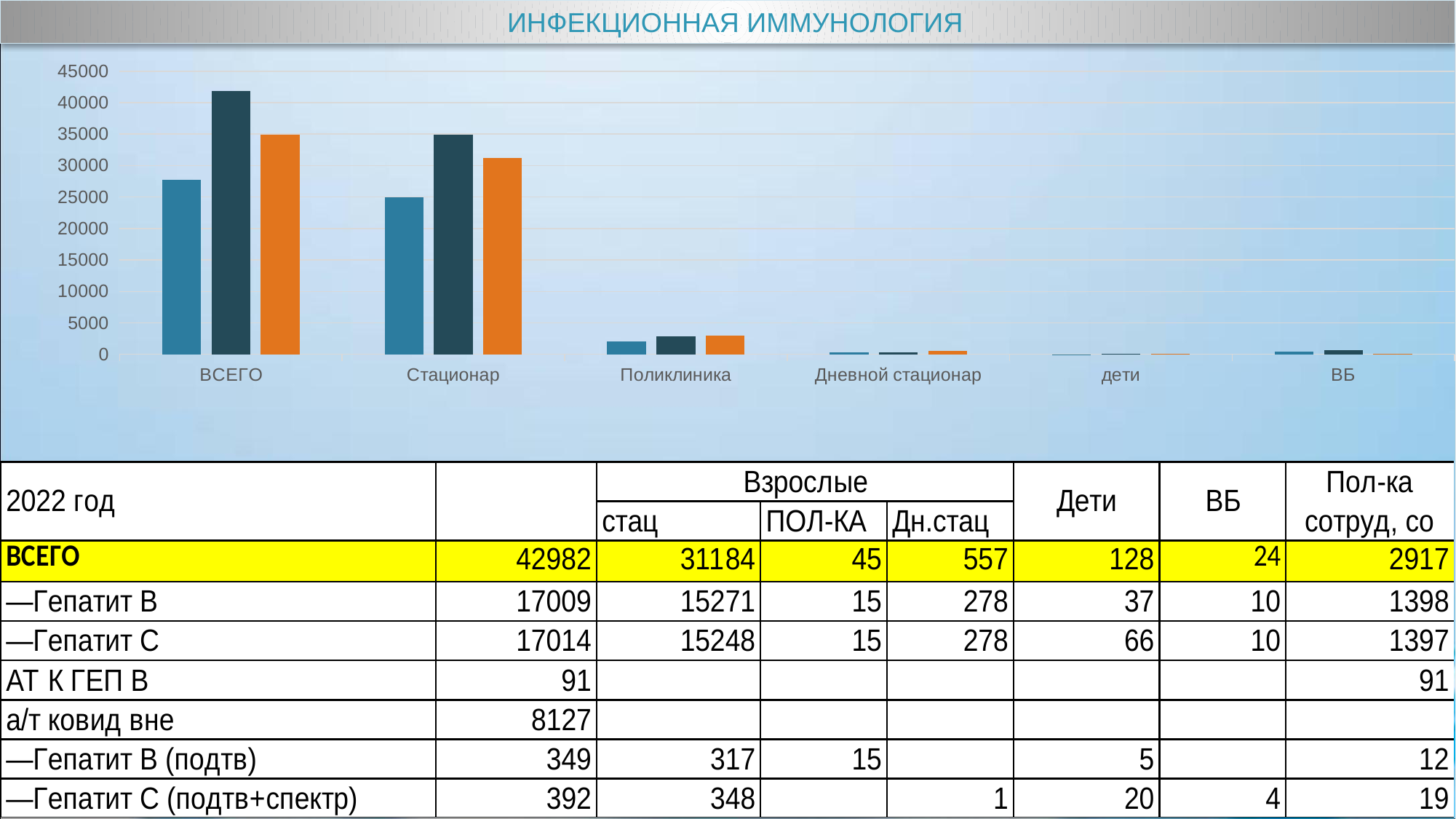
What kind of chart is shown on the slide? bar chart Which is larger: the orange bar for Стационар or the orange bar for Поликлиника? Стационар Is the value of the light blue bar for ВСЕГО greater or less than 30000? less Which category has the tallest bars in the chart? ВСЕГО Is the value of the dark teal bar for ВСЕГО greater or less than 40000? greater How many categories are shown on the x axis of the chart? 6 Is the value of the orange bar for Поликлиника greater or less than 5000? less Which is larger: the dark teal bar for ВСЕГО or the dark teal bar for Стационар? ВСЕГО Within the ВСЕГО category, which bar is taller: the light blue one or the dark teal one? dark teal What is the highest value shown on the chart's vertical axis? 45000 What is the title shown at the top of the slide? ИНФЕКЦИОННАЯ ИММУНОЛОГИЯ